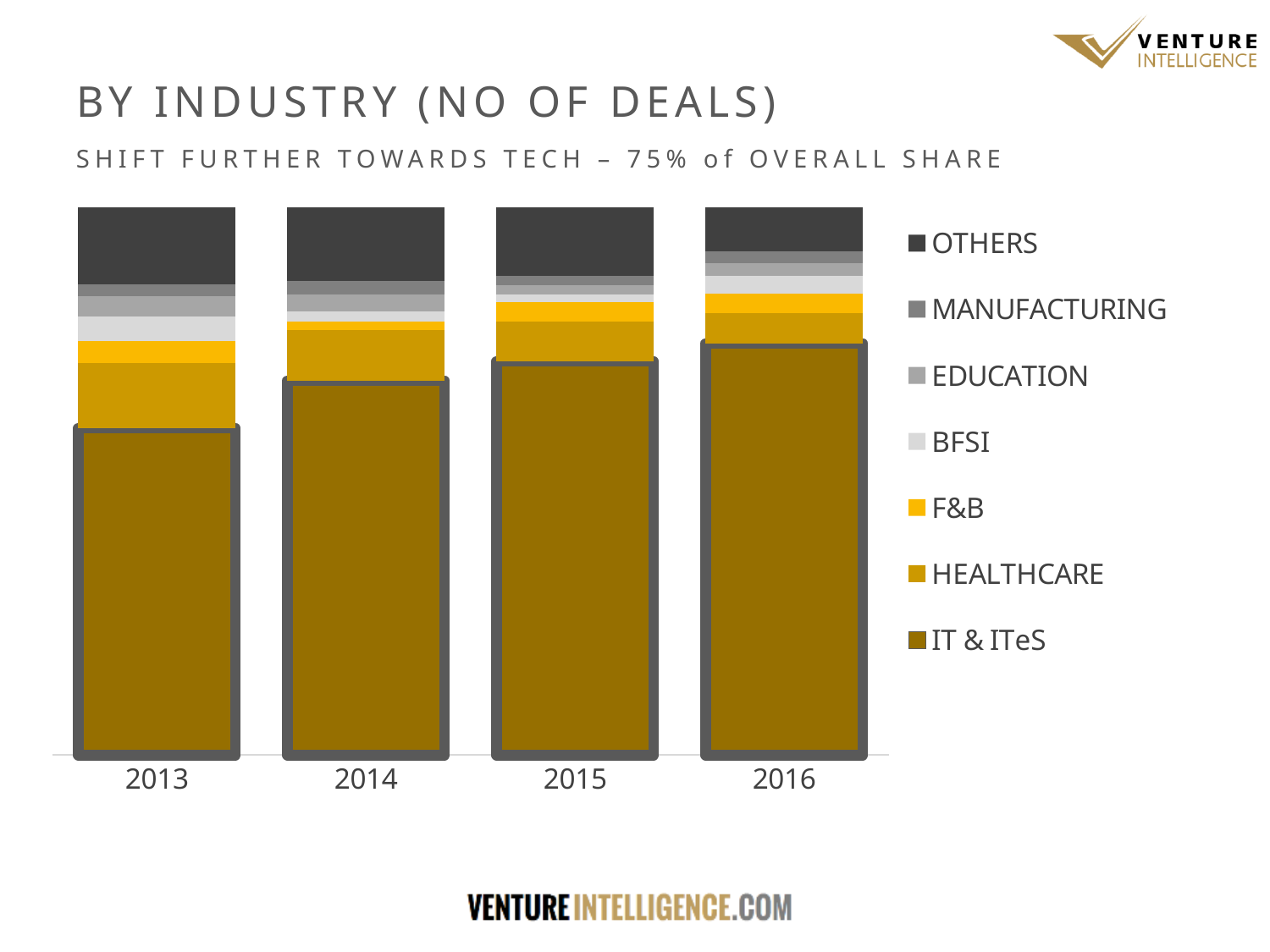
Which year has the smallest IT & ITeS segment? 2013 What is the title of the chart on the slide? BY INDUSTRY (NO OF DEALS) What kind of chart is shown on the slide? Stacked bar chart Is the IT & ITeS segment larger in 2013 or in 2016? 2016 How many years are shown on the x axis of the chart? 4 Does the IT & ITeS segment rise or fall from 2013 to 2016? Rise Does the HEALTHCARE segment rise or fall from 2013 to 2016? Fall Which series is shown at the bottom of each stacked bar? IT & ITeS How many series does the chart's legend list? 7 Which year has the largest HEALTHCARE segment? 2013 Which year has the largest IT & ITeS segment? 2016